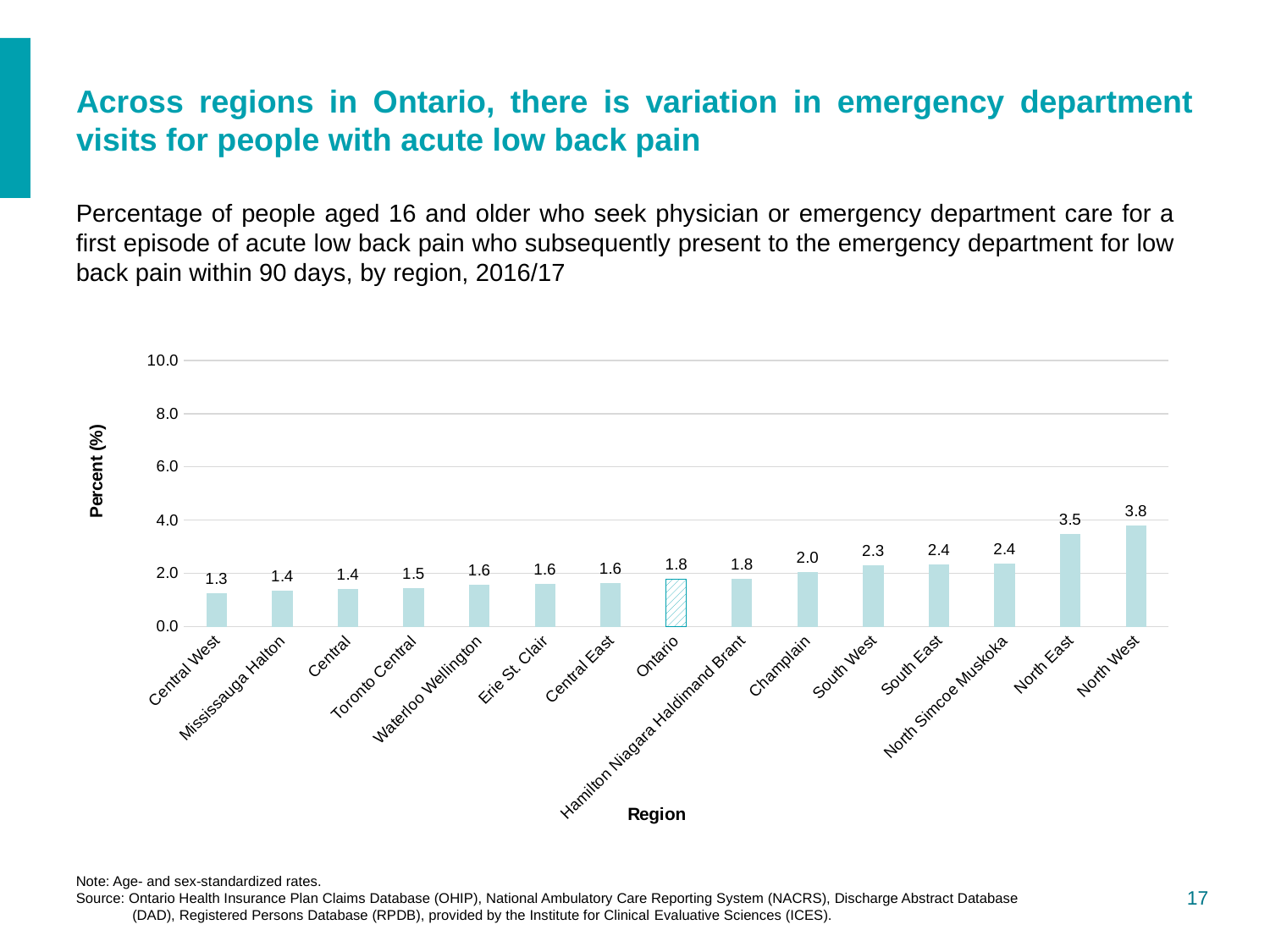
What is the label of the y axis? Percent (%) Which region has the highest value? North West What is the value for Champlain? 2.0 What is the value for North West? 3.8 Which is larger, the value for North East or the value for North Simcoe Muskoka? North East Which region has the lowest value? Central West What is the value for Toronto Central? 1.5 What is the difference between the values for North East and South West? 1.2 What kind of chart is shown on the slide? Bar chart What is the value for Ontario? 1.8 What is the difference between the values for North West and Central West? 2.5 How many regions are shown on the x axis? 15